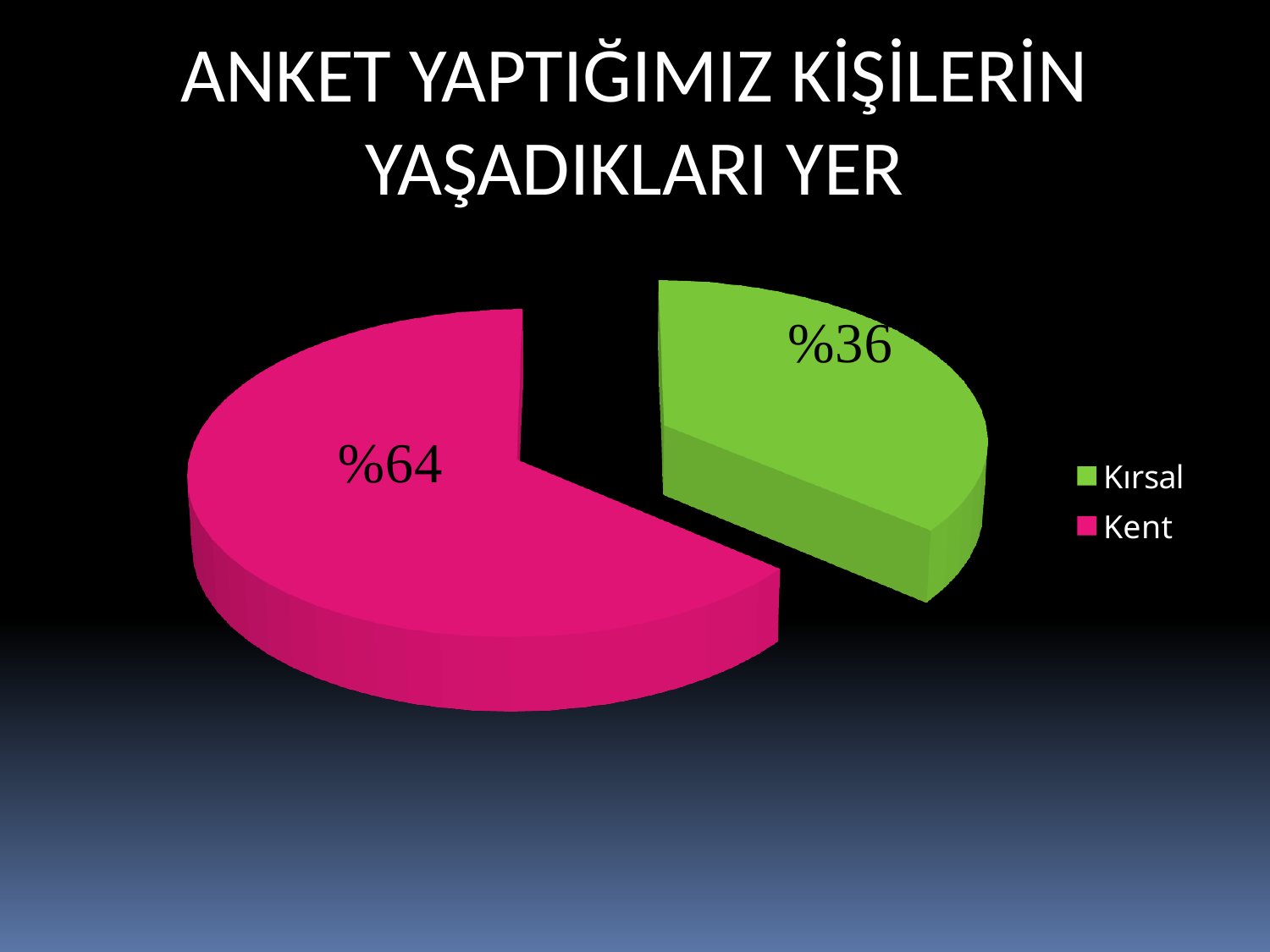
Which is larger, Kent or Kırsal? Kent What is the title of the slide? ANKET YAPTIĞIMIZ KİŞİLERİN YAŞADIKLARI YER What is the value shown for Kent? %64 What share of the pie does Kırsal represent? %36 How many slices does the pie chart have? 2 Which category has the largest slice? Kent How many entries does the legend list? 2 What colour is the Kent slice? pink What is the difference between the Kent and Kırsal values? %28 Which category has the smallest slice? Kırsal What is the value shown for Kırsal? %36 What kind of chart is shown on the slide? pie chart